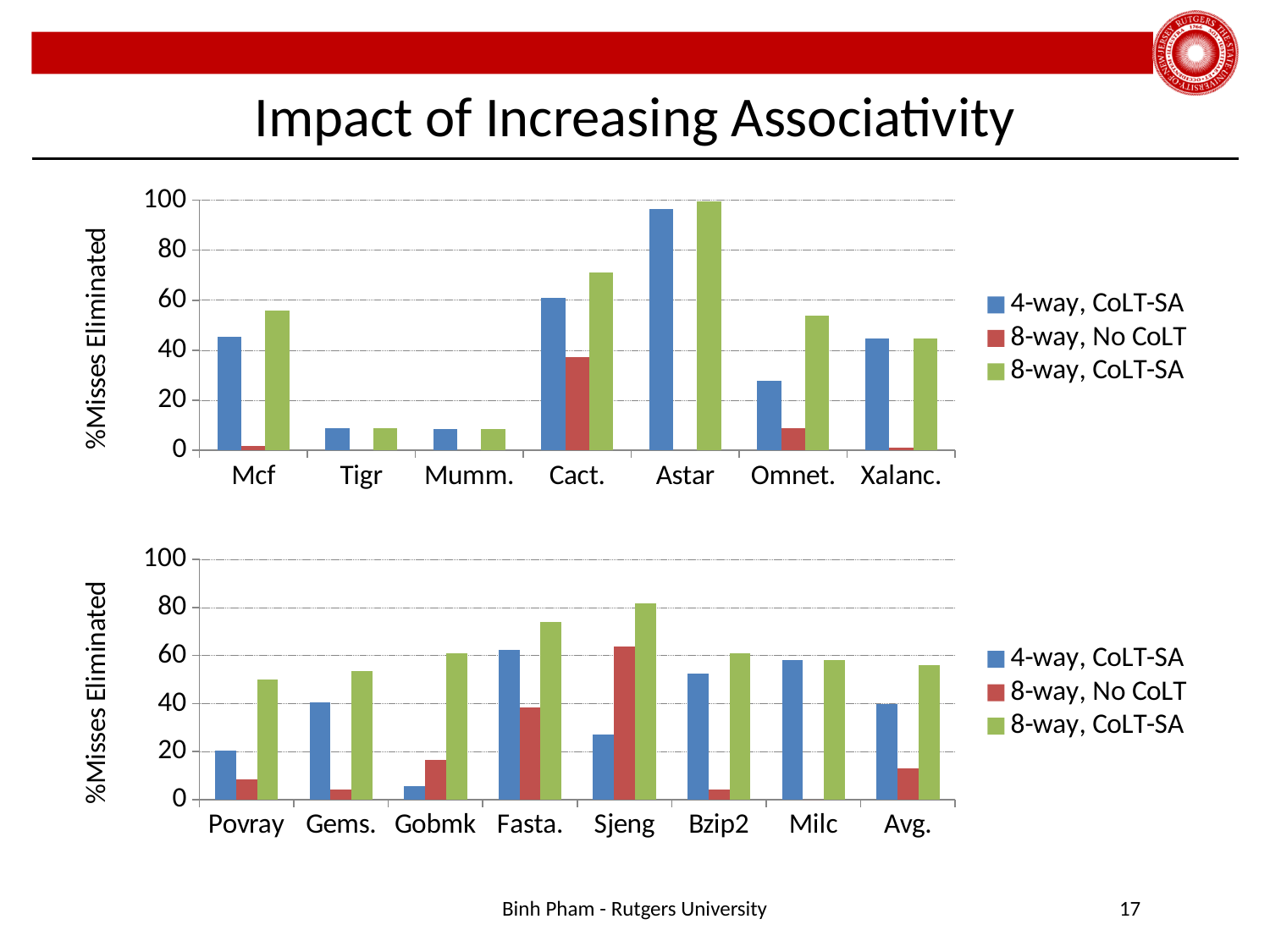
How many categories are shown on the x axis of the bottom chart? 8 How many series does the legend of the bottom chart list? 3 In the bottom chart, for Sjeng, which is larger: the 4-way, CoLT-SA value or the 8-way, No CoLT value? 8-way, No CoLT In the top chart, is the 8-way, CoLT-SA value for Mcf greater or less than 40? greater How many categories are shown on the x axis of the top chart? 7 In the bottom chart, which category has the lowest value for the 4-way, CoLT-SA series? Gobmk In the top chart, for Cact., which is larger: the 8-way, No CoLT value or the 8-way, CoLT-SA value? 8-way, CoLT-SA What is the y-axis label of the bottom chart? %Misses Eliminated In the top chart, is the 4-way, CoLT-SA value for Omnet. greater or less than 40? less In the top chart, which category has the highest value for the 8-way, CoLT-SA series? Astar What kind of chart is the top chart on the slide? bar chart In the bottom chart, which category has the highest value for the 8-way, CoLT-SA series? Sjeng